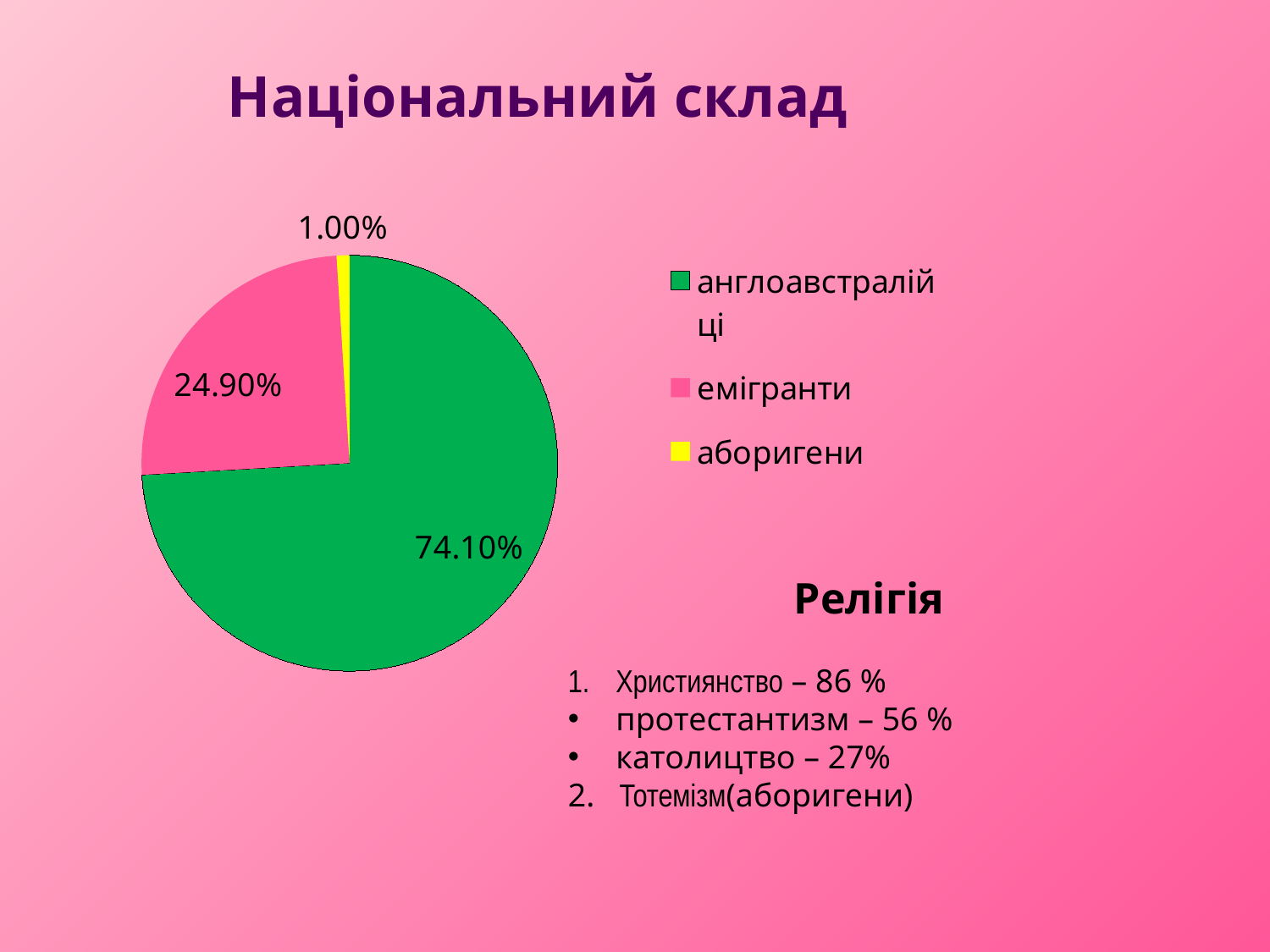
What colour is the аборигени slice in the pie chart? yellow What share of the pie does the англоавстралійці slice have? 74.10% What kind of chart is shown on the slide? pie chart Which category has the smallest slice of the pie? аборигени What is the difference between the емігранти share and the аборигени share? 23.90% How many slices does the pie chart have? 3 Which is larger, the емігранти slice or the аборигени slice? емігранти What share of the pie does the аборигени slice have? 1.00% What is the difference between the англоавстралійці share and the емігранти share? 49.20% Which category has the largest slice of the pie? англоавстралійці What share of the pie does the емігранти slice have? 24.90% How many entries does the legend list? 3